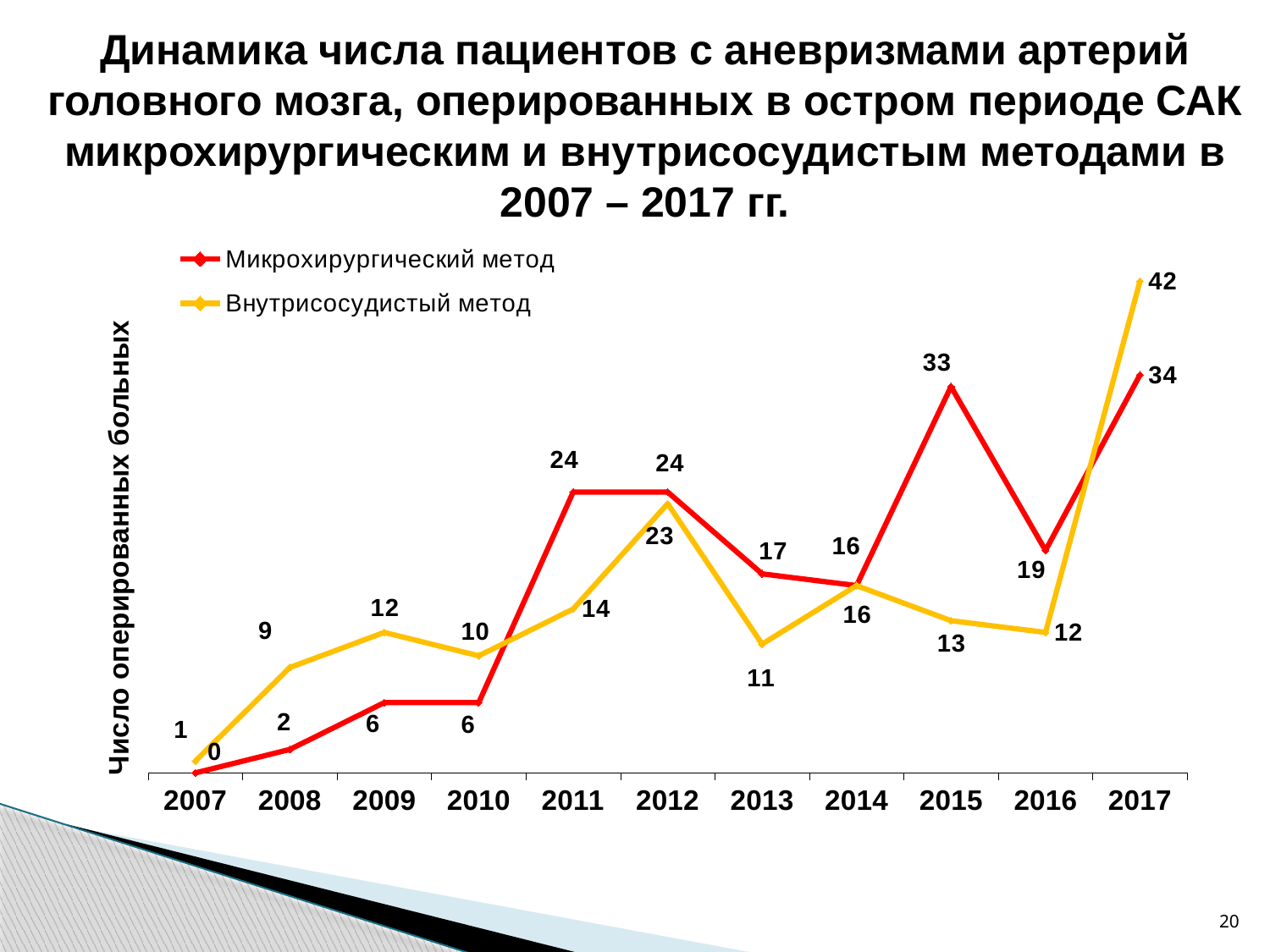
How many series does the legend list? 2 What is the label of the y axis? Число оперированных больных In which year is the value for Микрохирургический метод lowest? 2007 In which year is the value for Микрохирургический метод highest? 2017 Does the value for Внутрисосудистый метод rise or fall from 2016 to 2017? Rise What is the value for Внутрисосудистый метод in 2017? 42 What is the value for Внутрисосудистый метод in 2013? 11 What is the difference between the two methods in 2017? 8 What type of chart is shown on the slide? Line chart Which method has the larger value in 2015? Микрохирургический метод How many years are shown on the x axis? 11 What is the value for Микрохирургический метод in 2015? 33